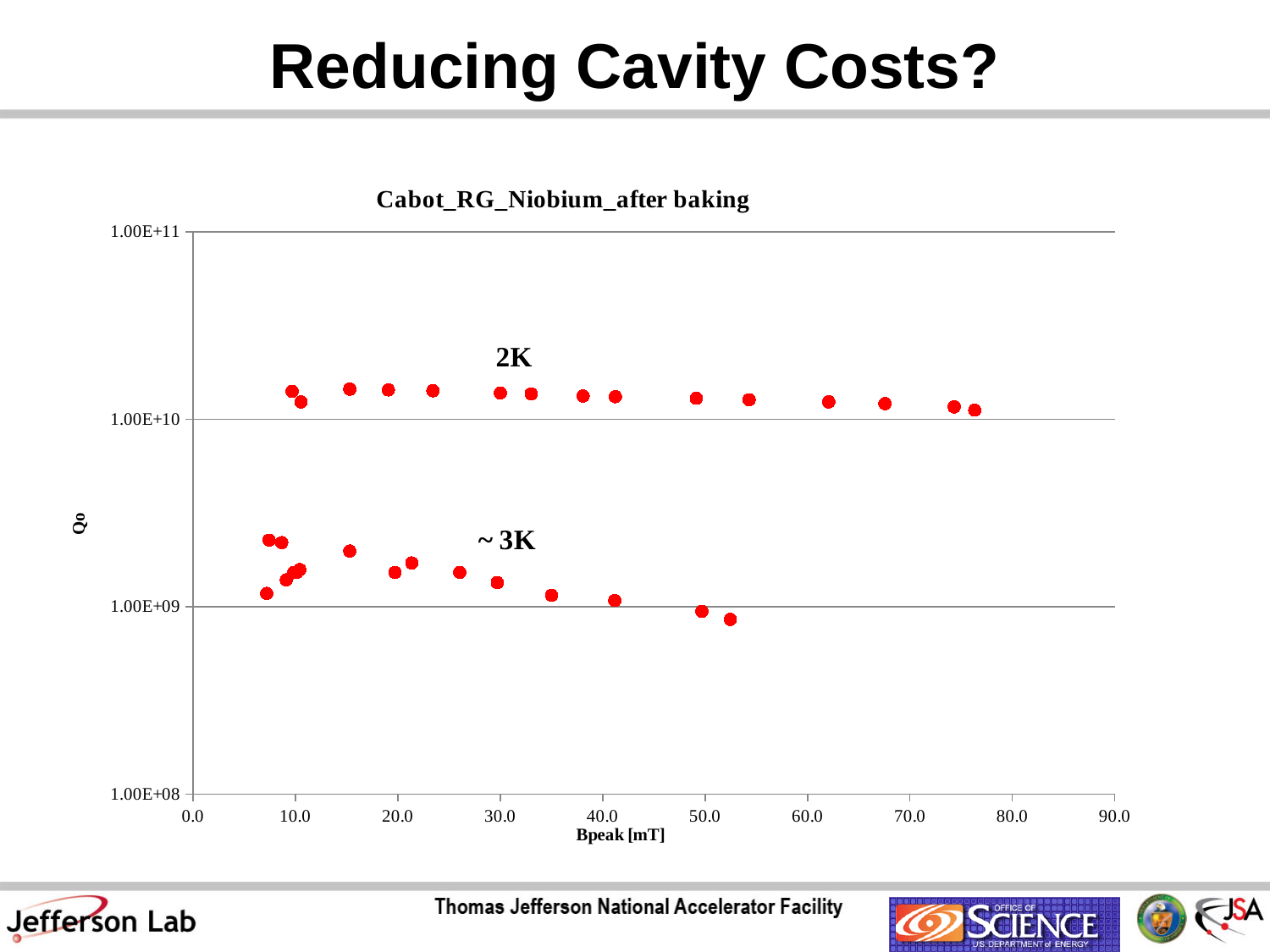
Is the Qo value of the ~ 3K series at Bpeak of about 15 mT greater or less than 1.00E+09? greater What is the label of the x axis of the chart? Bpeak [mT] Is the Qo value of the 2K series at Bpeak of about 30 mT greater or less than 1.00E+10? greater Is the Qo value of the ~ 3K series at Bpeak of about 52 mT greater or less than 1.00E+09? less Does the Qo of the ~ 3K series rise or fall as Bpeak increases from about 30 mT to about 52 mT? fall At Bpeak of about 30 mT, which series has the higher Qo, 2K or ~ 3K? 2K What is the title of the chart? Cabot_RG_Niobium_after baking How many data series are labelled on the chart? 2 What kind of chart is shown on the slide? scatter chart Does the Qo of the 2K series rise or fall as Bpeak increases from about 15 mT to about 76 mT? fall